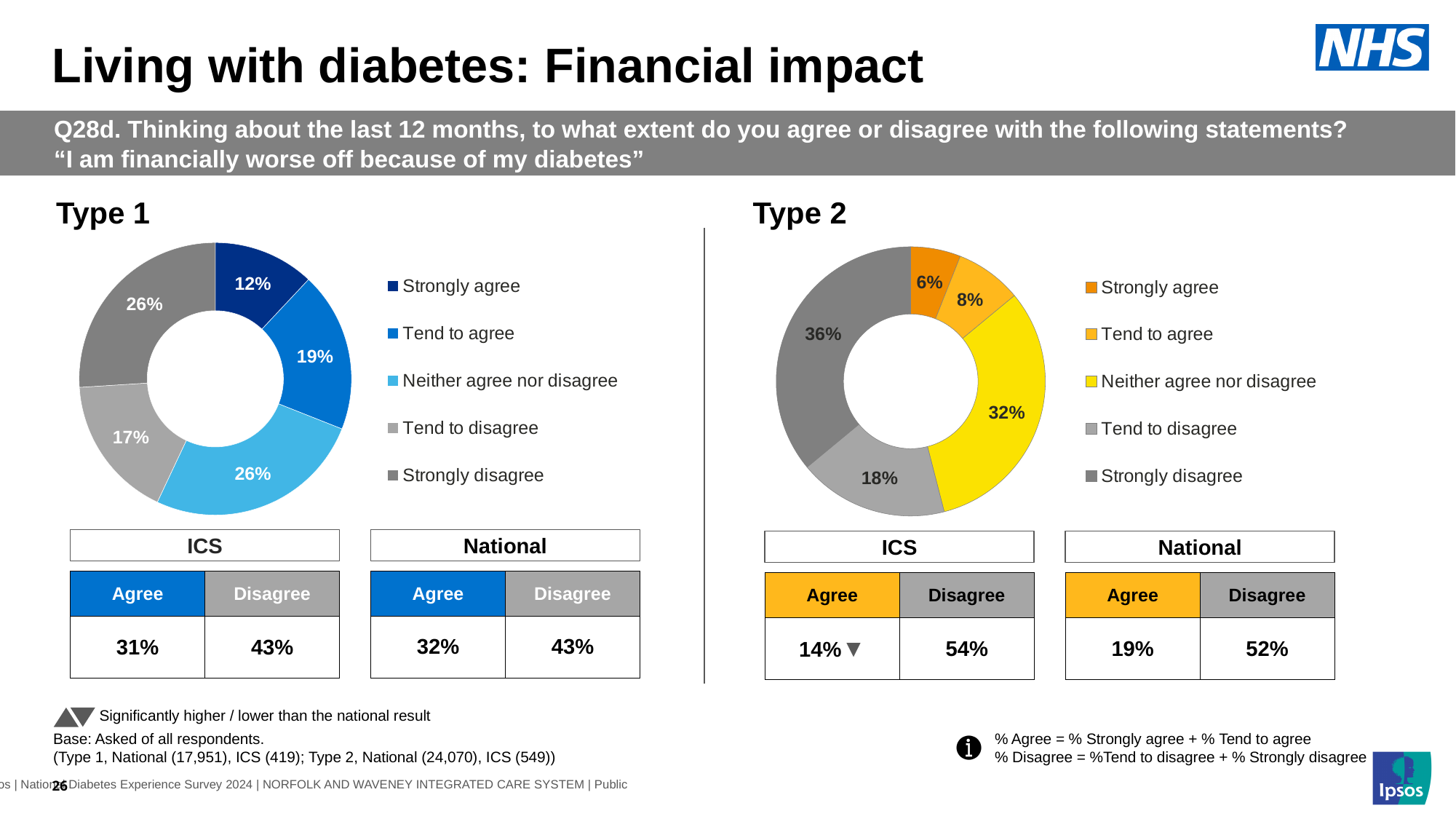
In the Type 1 chart, what percentage of respondents said 'Tend to disagree'? 17% In the Type 1 chart, what is the difference between the 'Strongly disagree' and 'Tend to disagree' shares? 9 percentage points In the Type 1 chart, what percentage of respondents said 'Strongly agree'? 12% What kind of chart is used to show the Type 2 results? Doughnut (pie) chart In the Type 1 chart, which response category has the smallest share? Strongly agree In the Type 2 chart, what colour represents 'Neither agree nor disagree'? Yellow In the Type 2 chart, what is the difference between the 'Strongly disagree' and 'Strongly agree' shares? 30 percentage points In the Type 2 chart, which is larger: the 'Tend to agree' share or the 'Tend to disagree' share? Tend to disagree How many response categories does the legend of the Type 1 chart list? 5 In the Type 2 chart, which response category has the smallest share? Strongly agree In the Type 2 chart, which response category has the largest share? Strongly disagree In the Type 2 chart, what percentage of respondents said 'Neither agree nor disagree'? 32%